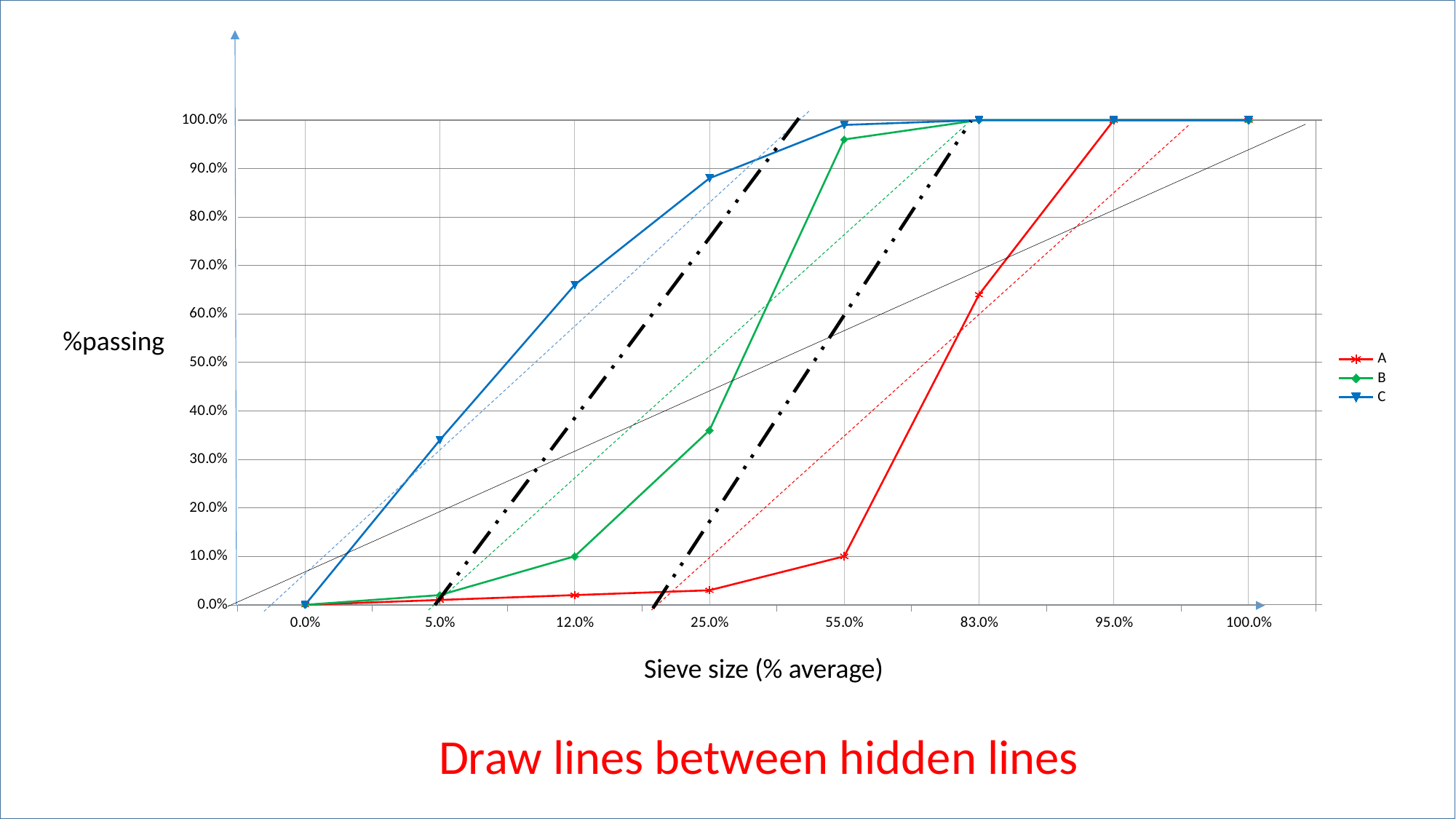
What is the value of series B at sieve size 12.0%? 10.0% Which series has the highest value at sieve size 25.0%? C What is the value of series A at sieve size 55.0%? 10.0% How many sieve size categories are shown on the x axis? 8 Is the value for series C at sieve size 12.0% greater or less than 60.0%? greater What is the value of series C at sieve size 83.0%? 100.0% At sieve size 55.0%, which series has the larger value, A or B? B What is the label on the x axis? Sieve size (% average) How many series does the legend list? 3 Is the value for series A at sieve size 25.0% greater or less than 10.0%? less What kind of chart is shown on the slide? line chart Do the values of series C rise or fall as sieve size increases from 0.0% to 83.0%? rise